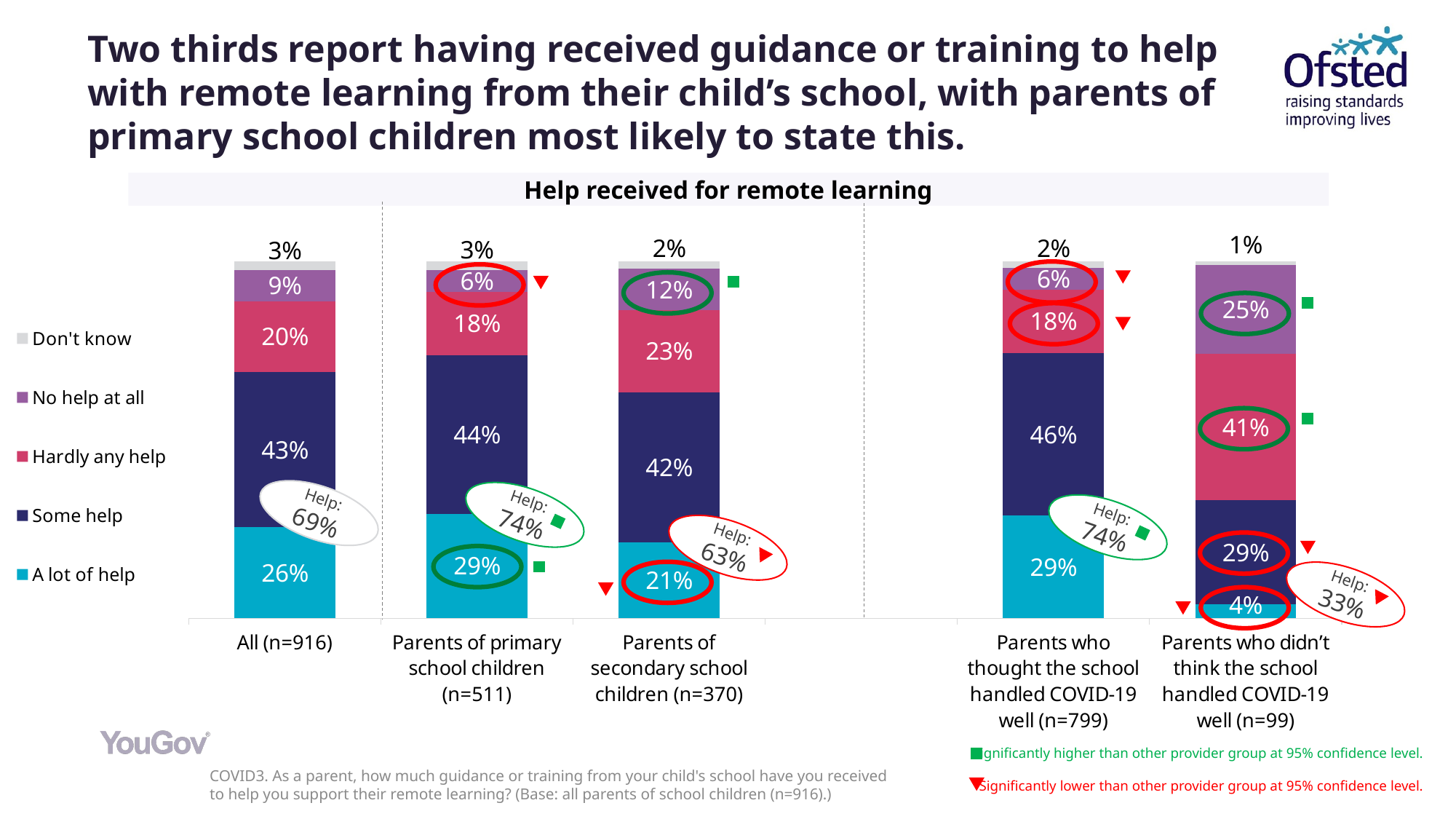
What percentage of all parents (n=916) reported receiving a lot of help? 26% What is the difference in the 'No help at all' percentage between parents of secondary school children and parents of primary school children? 6 percentage points What kind of chart is shown on the slide? Stacked bar chart How many parent groups are shown on the x axis of the chart? 5 What is the combined 'Help' total (a lot of help plus some help) shown for parents of primary school children? 74% Which group has the highest percentage for 'Some help'? Parents who thought the school handled COVID-19 well (n=799) What is the difference in the 'Some help' percentage between all parents and parents who didn't think the school handled COVID-19 well? 14 percentage points How many series does the legend list? 5 What is the 'Don't know' percentage for parents of secondary school children? 2% Which group has the lowest percentage for 'A lot of help'? Parents who didn't think the school handled COVID-19 well (n=99) Which group has a larger 'Hardly any help' percentage: parents of primary school children or parents of secondary school children? Parents of secondary school children What percentage of parents who didn't think the school handled COVID-19 well reported no help at all? 25%